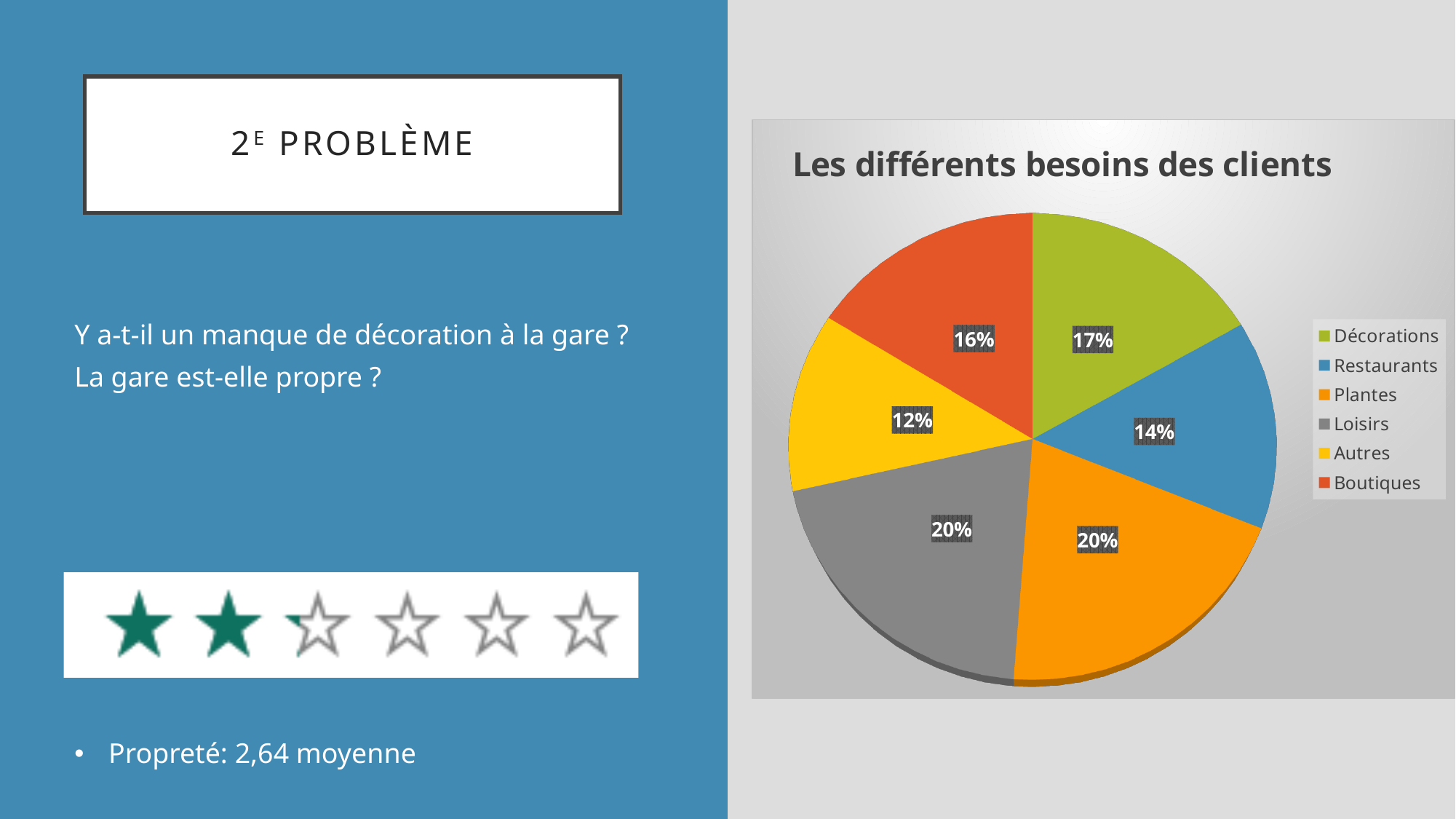
What is the value shown for Autres? 12% What is the difference between the Plantes share and the Autres share? 8% Which is larger, the share for Décorations or the share for Restaurants? Décorations What colour is the Boutiques slice? red How many categories does the legend list? 6 What type of chart is shown on the slide? pie chart What share of the pie does Décorations represent? 17% Which category has the smallest slice of the pie? Autres What is the title of the chart? Les différents besoins des clients What is the value shown for Boutiques? 16% What is the value shown for Restaurants? 14% What is the value shown for Loisirs? 20%